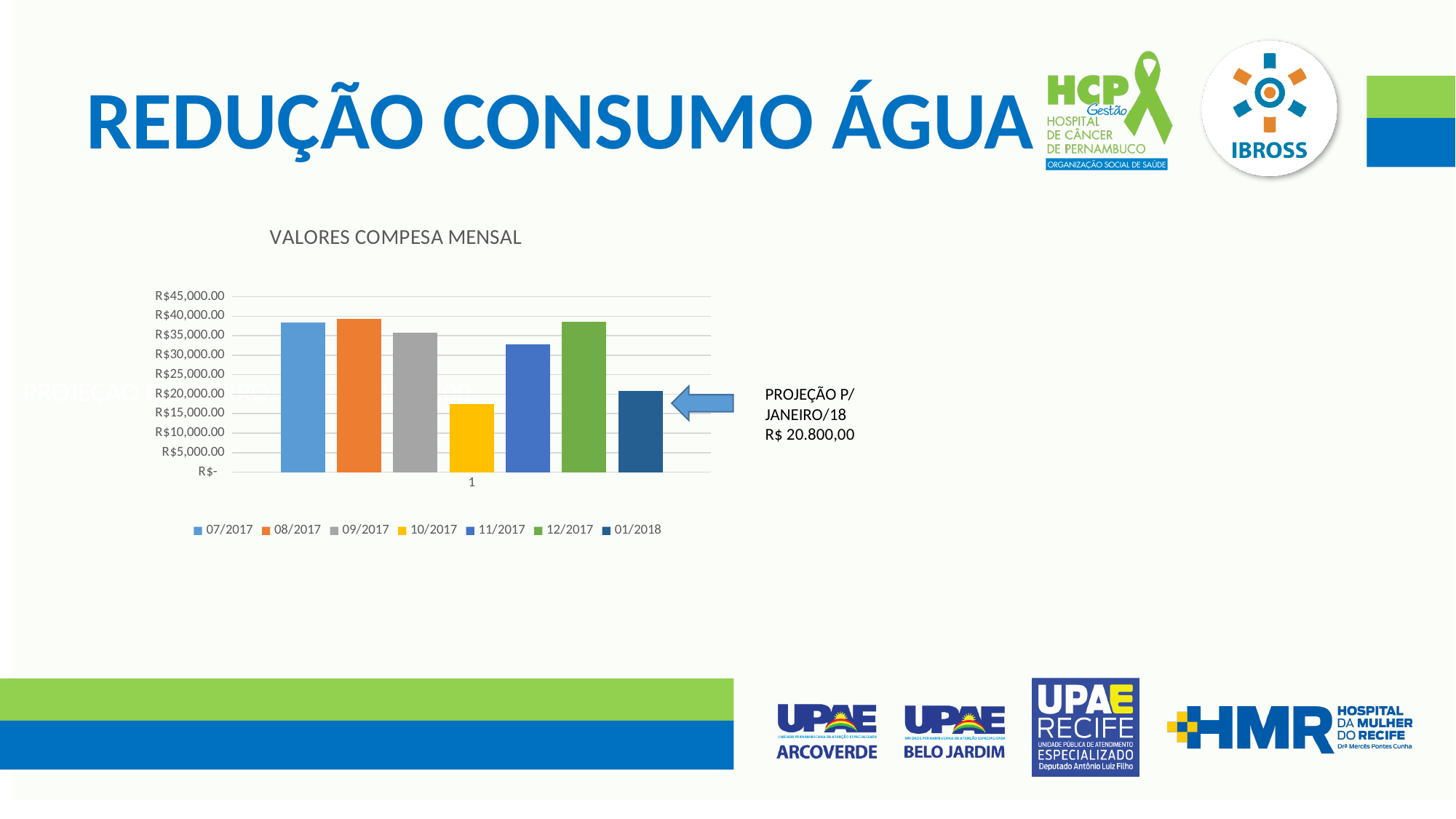
Is the value for 01/2018 greater or less than R$25,000.00? less Is the value for 07/2017 greater or less than R$35,000.00? greater Which series has the lowest value in the chart? 10/2017 Is the value for 10/2017 greater or less than R$20,000.00? less What is the title of the chart? VALORES COMPESA MENSAL What colour is the bar for 10/2017? yellow Which is larger, the value for 12/2017 or the value for 01/2018? 12/2017 What kind of chart is shown on the slide? bar chart What is the projected value for January 2018 (01/2018) shown next to the chart? R$ 20.800,00 Which is larger, the value for 10/2017 or the value for 11/2017? 11/2017 How many series does the chart legend list? 7